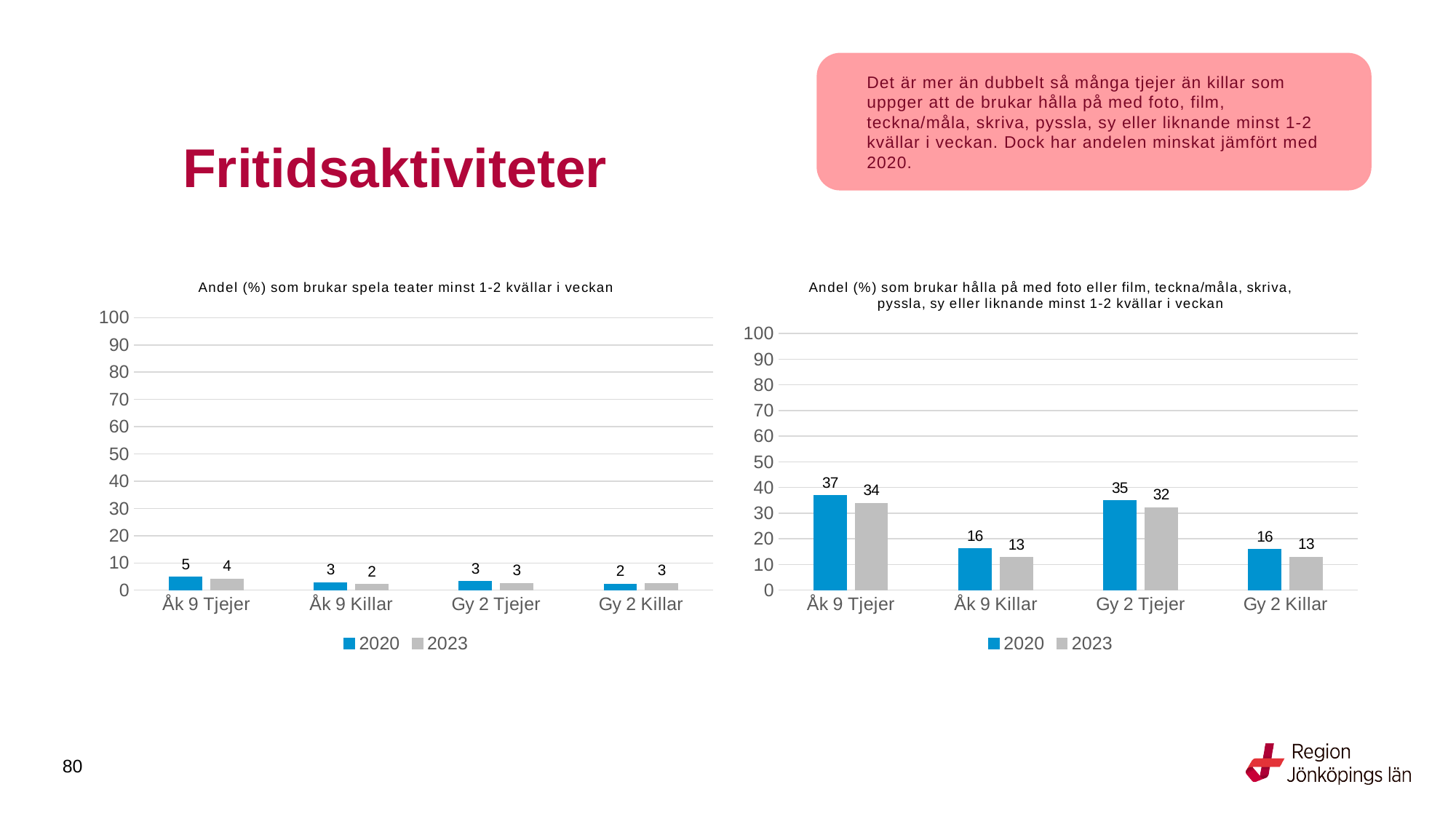
In the right chart (foto eller film, teckna/måla, skriva, pyssla...), which is larger: the 2023 value for Åk 9 Killar or the 2023 value for Gy 2 Tjejer? Gy 2 Tjejer In the left chart (Andel (%) som brukar spela teater minst 1-2 kvällar i veckan), what is the value for Åk 9 Tjejer in 2020? 5 How many categories are shown on the x axis of the left chart (spela teater)? 4 In the right chart (foto eller film, teckna/måla, skriva, pyssla...), is the 2020 value for Gy 2 Tjejer greater or less than 30? greater In the left chart (spela teater), what is the value for Gy 2 Killar in 2023? 3 In the right chart (foto eller film, teckna/måla, skriva, pyssla...), what is the difference between the 2020 and 2023 values for Åk 9 Tjejer? 3 How many series does the legend of the right chart (foto eller film, teckna/måla, skriva, pyssla...) list? 2 In the left chart (spela teater), which category has the lowest value in 2023? Åk 9 Killar What kind of chart is the left chart (spela teater)? Bar chart In the right chart (foto eller film, teckna/måla, skriva, pyssla...), what is the value for Gy 2 Tjejer in 2023? 32 In the right chart (foto eller film, teckna/måla, skriva, pyssla...), which category has the highest value in 2020? Åk 9 Tjejer Which colour represents the 2020 series in the right chart (foto eller film, teckna/måla, skriva, pyssla...)? Blue